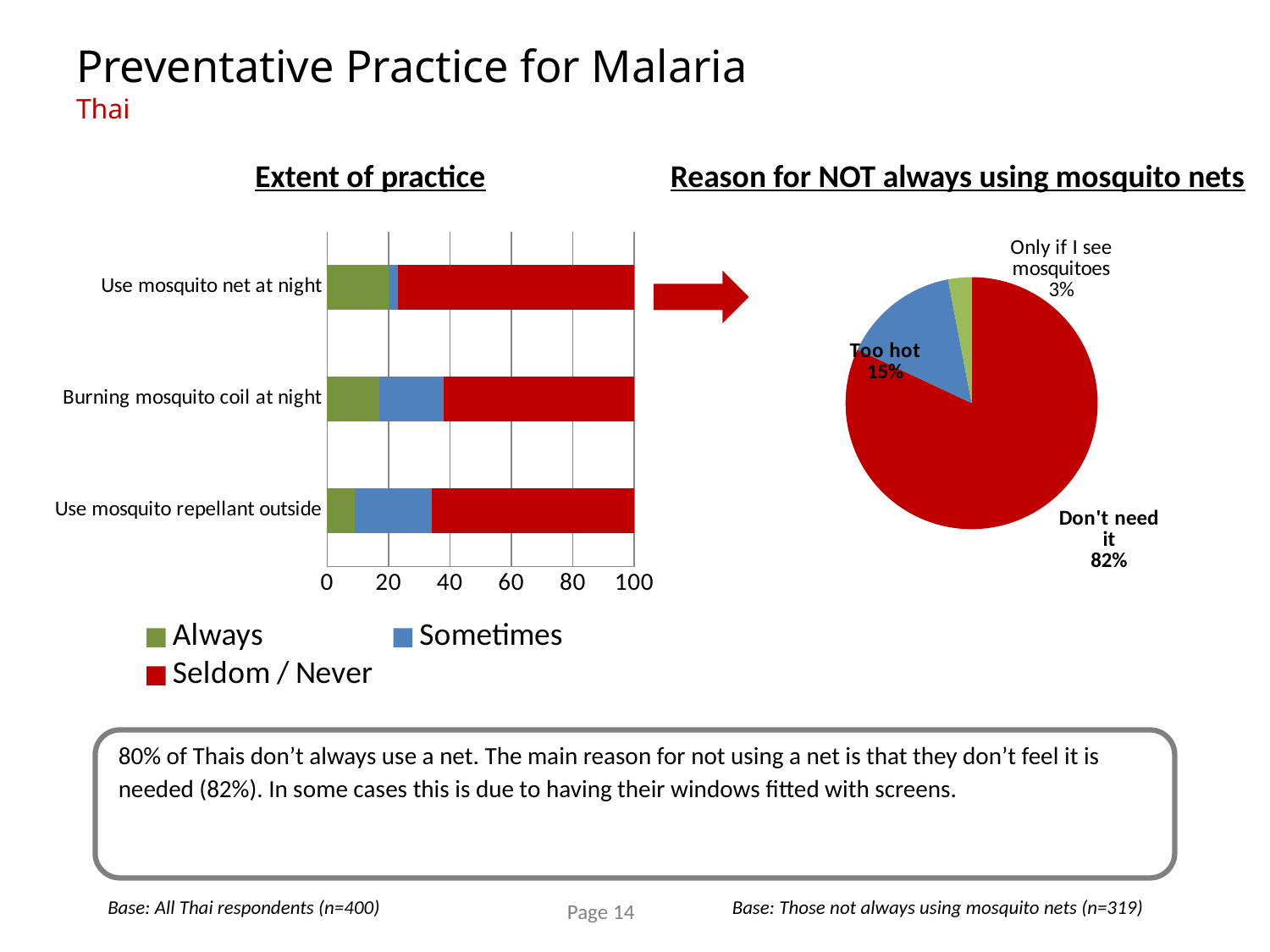
How many series does the legend of the 'Extent of practice' chart list? 3 What kind of chart is the 'Extent of practice' chart? Bar chart In the 'Extent of practice' chart, is the 'Seldom / Never' value for 'Use mosquito net at night' greater or less than 60? greater In the 'Reason for NOT always using mosquito nets' pie chart, what share is labelled for 'Only if I see mosquitoes'? 3% In the 'Reason for NOT always using mosquito nets' pie chart, what share is labelled for 'Too hot'? 15% In the 'Extent of practice' chart, which has the larger 'Sometimes' value: 'Use mosquito net at night' or 'Burning mosquito coil at night'? Burning mosquito coil at night In the 'Reason for NOT always using mosquito nets' pie chart, how many percentage points larger is 'Don't need it' than 'Too hot'? 67 percentage points In the 'Extent of practice' chart, is the 'Always' value for 'Use mosquito repellant outside' greater or less than 20? less How many slices does the 'Reason for NOT always using mosquito nets' pie chart have? 3 In the 'Reason for NOT always using mosquito nets' pie chart, what share is labelled for 'Don't need it'? 82% In the 'Reason for NOT always using mosquito nets' pie chart, which reason has the largest share? Don't need it In the 'Reason for NOT always using mosquito nets' pie chart, which reason has the smallest share? Only if I see mosquitoes